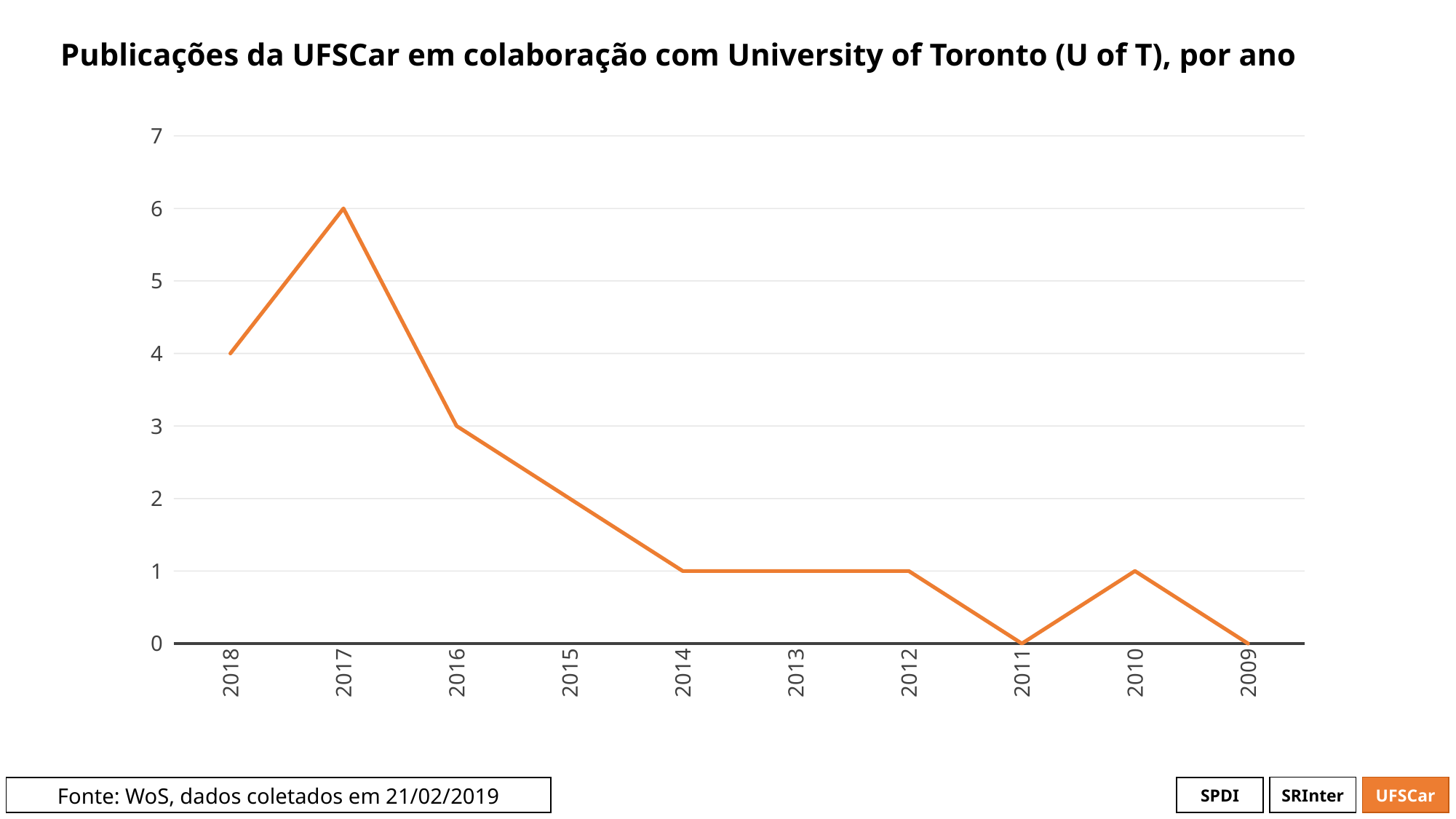
Which year has the highest number of publications? 2017 How many publications are shown for 2015? 2 What is the difference between the values for 2017 and 2018? 2 How many publications are shown for 2017? 6 Is the value for 2017 greater or less than 5? greater How many years are shown on the x axis? 10 What is the value shown for 2011? 0 Which year has the larger value, 2016 or 2014? 2016 What is the title of the chart? Publicações da UFSCar em colaboração com University of Toronto (U of T), por ano How many publications are shown for 2016? 3 How many publications are shown for 2018? 4 What kind of chart is shown on the slide? line chart